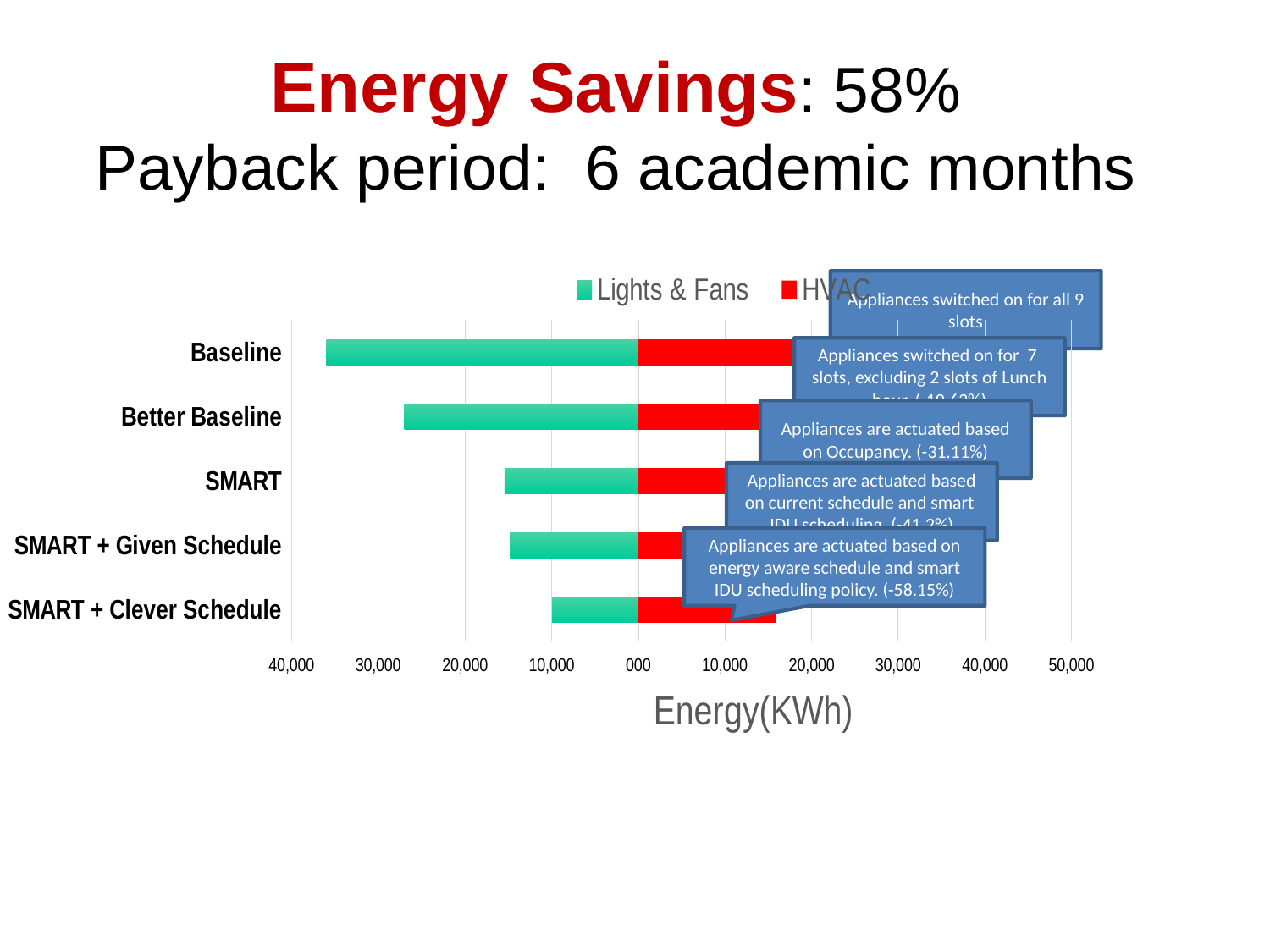
Is the Lights & Fans value for Better Baseline greater or less than 20,000? greater What is the title of the chart's horizontal axis? Energy(KWh) Which has the larger HVAC value, Baseline or SMART? Baseline What kind of chart is shown on the slide? bar chart How many categories are plotted on the chart? 5 Which category has the lowest Lights & Fans value? SMART + Clever Schedule Which has the larger Lights & Fans value, Baseline or Better Baseline? Baseline Is the Lights & Fans value for SMART greater or less than 20,000? less Which category has the highest Lights & Fans value? Baseline Is the Lights & Fans value for Baseline greater or less than 30,000? greater How many series does the chart's legend list? 2